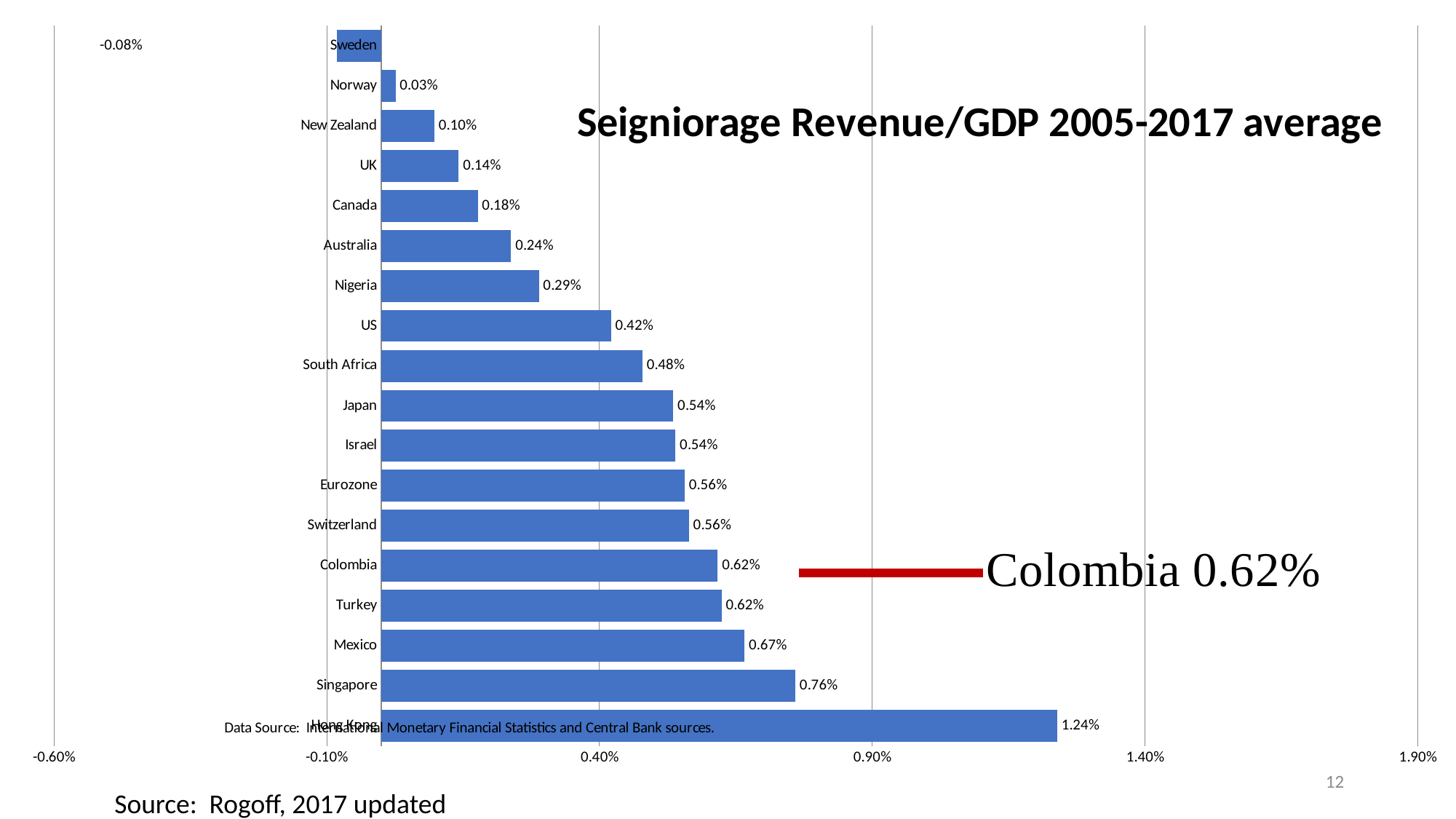
What is the value shown for Colombia? 0.62% What is the title of the chart? Seigniorage Revenue/GDP 2005-2017 average What is the value shown for Sweden? -0.08% What is the value shown for Singapore? 0.76% What is the value shown for the US? 0.42% What is the difference between the values for Mexico and Canada? 0.49% What kind of chart is shown on the slide? Bar chart Which has the larger value, Nigeria or Australia? Nigeria How many countries or regions are shown in the chart? 18 What is the largest value shown in the chart? 1.24% Which country has the lowest value in the chart? Sweden What is the value shown for Japan? 0.54%